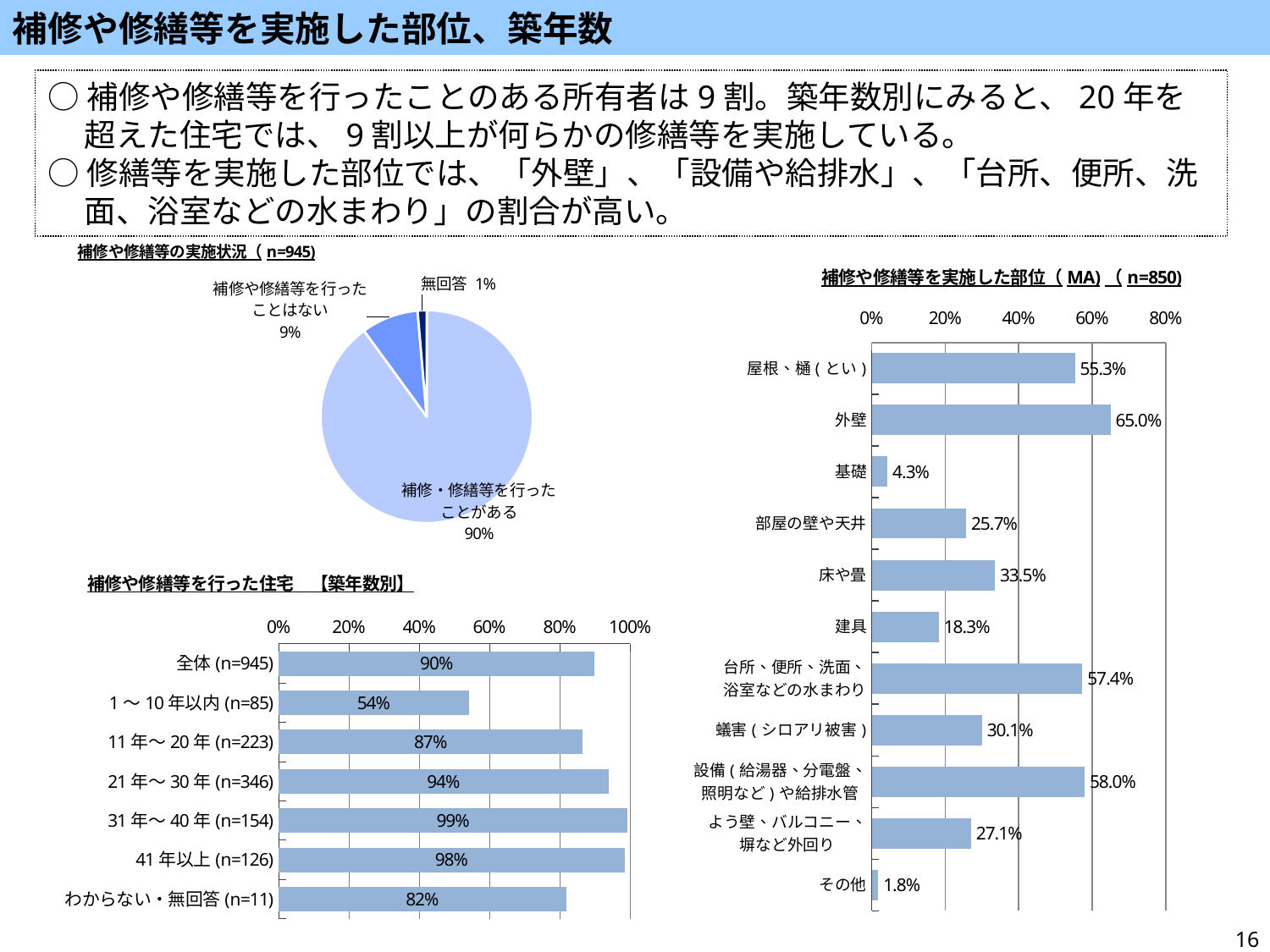
In the pie chart titled 補修や修繕等の実施状況, what share is labelled 無回答? 1% In the chart titled 補修や修繕等を実施した部位 (MA) (n=850), what is the value for 外壁? 65.0% How many categories are shown in the chart titled 補修や修繕等を行った住宅【築年数別】? 7 In the chart titled 補修や修繕等を行った住宅【築年数別】, what is the difference between 21年～30年 (n=346) and 11年～20年 (n=223)? 7% In the chart titled 補修や修繕等を実施した部位 (MA) (n=850), which is larger, 床や畳 or 蟻害(シロアリ被害)? 床や畳 In the chart titled 補修や修繕等を実施した部位 (MA) (n=850), which category has the lowest value? その他 In the pie chart titled 補修や修繕等の実施状況, what share is labelled 補修・修繕等を行ったことがある? 90% What kind of chart is the chart titled 補修や修繕等を実施した部位 (MA) (n=850)? bar chart In the chart titled 補修や修繕等を行った住宅【築年数別】, which category has the lowest value? 1～10年以内 (n=85) What kind of chart is the chart titled 補修や修繕等の実施状況? pie chart In the chart titled 補修や修繕等を行った住宅【築年数別】, what is the value for 1～10年以内 (n=85)? 54% In the chart titled 補修や修繕等を行った住宅【築年数別】, which category has the highest value? 31年～40年 (n=154)